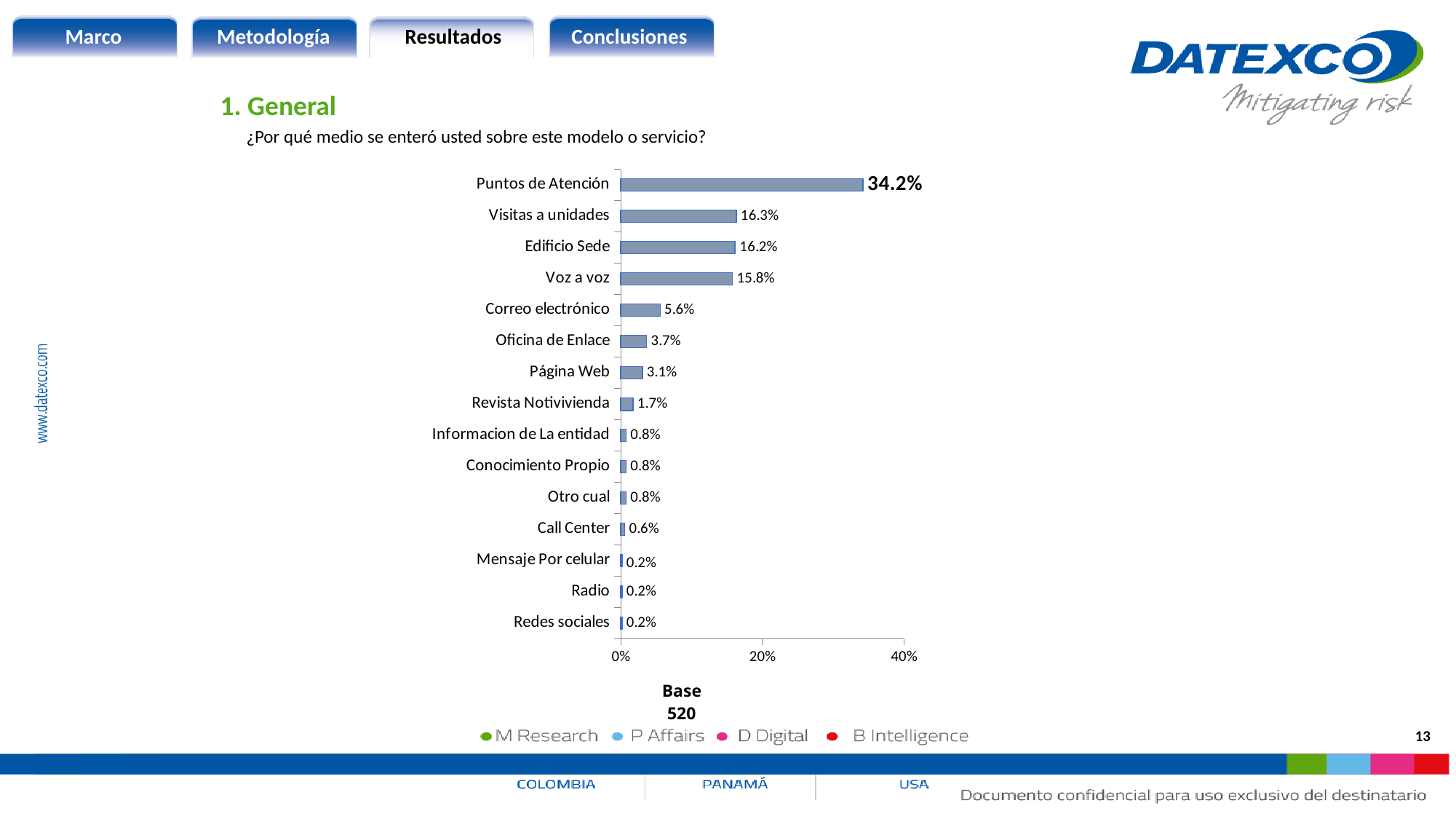
Which category has the highest value in the chart? Puntos de Atención Do the bar values increase or decrease going from the top category to the bottom category? Decrease Is the value for Puntos de Atención greater or less than 20%? greater How many categories are shown in the chart? 15 What is the difference between the values for Puntos de Atención and Visitas a unidades? 17.9 percentage points What is the value for Correo electrónico? 5.6% Which has a larger value, Correo electrónico or Oficina de Enlace? Correo electrónico What percentage is shown for Revista Notivivienda? 1.7% What percentage is shown for Puntos de Atención? 34.2% What kind of chart is shown on the slide? Bar chart What is the base (number of respondents) shown below the chart? 520 What is the value for Call Center? 0.6%